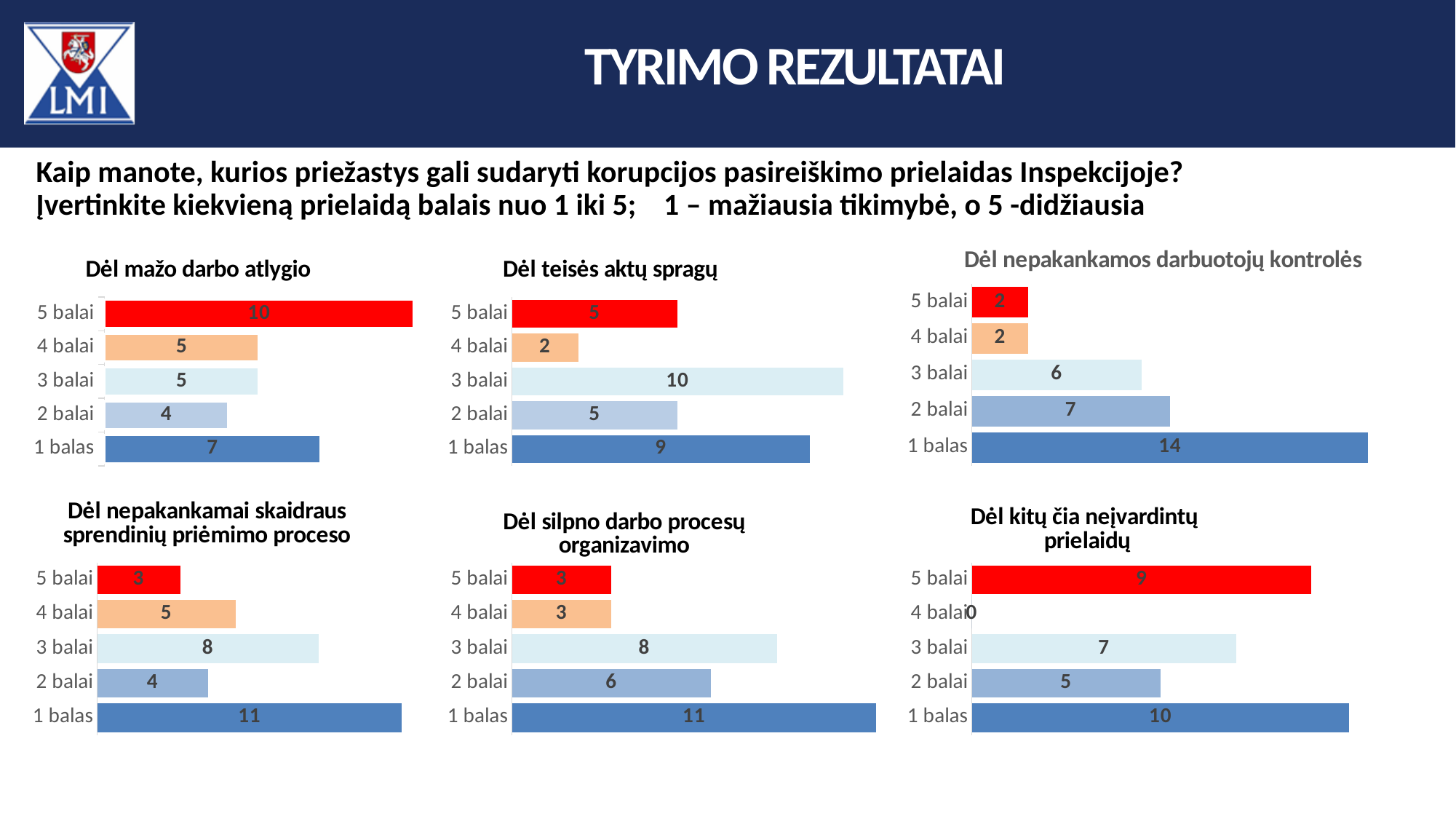
How many charts are shown on the slide? 6 In the chart titled "Dėl kitų čia neįvardintų prielaidų", what is the value for 4 balai? 0 How many categories does the chart titled "Dėl teisės aktų spragų" show? 5 In the chart titled "Dėl teisės aktų spragų", which category has the highest value? 3 balai In the chart titled "Dėl nepakankamai skaidraus sprendinių priėmimo proceso", which category has the lowest value? 5 balai In the chart titled "Dėl silpno darbo procesų organizavimo", what is the value for 3 balai? 8 In the chart titled "Dėl mažo darbo atlygio", what is the total of all five values? 31 What kind of chart is the chart titled "Dėl silpno darbo procesų organizavimo"? Bar chart In the chart titled "Dėl nepakankamos darbuotojų kontrolės", what is the difference between the values for 1 balas and 2 balai? 7 In the chart titled "Dėl nepakankamos darbuotojų kontrolės", what is the value for 1 balas? 14 In the chart titled "Dėl kitų čia neįvardintų prielaidų", which is larger: the value for 5 balai or the value for 1 balas? 1 balas In the chart titled "Dėl mažo darbo atlygio", what is the value for 5 balai? 10